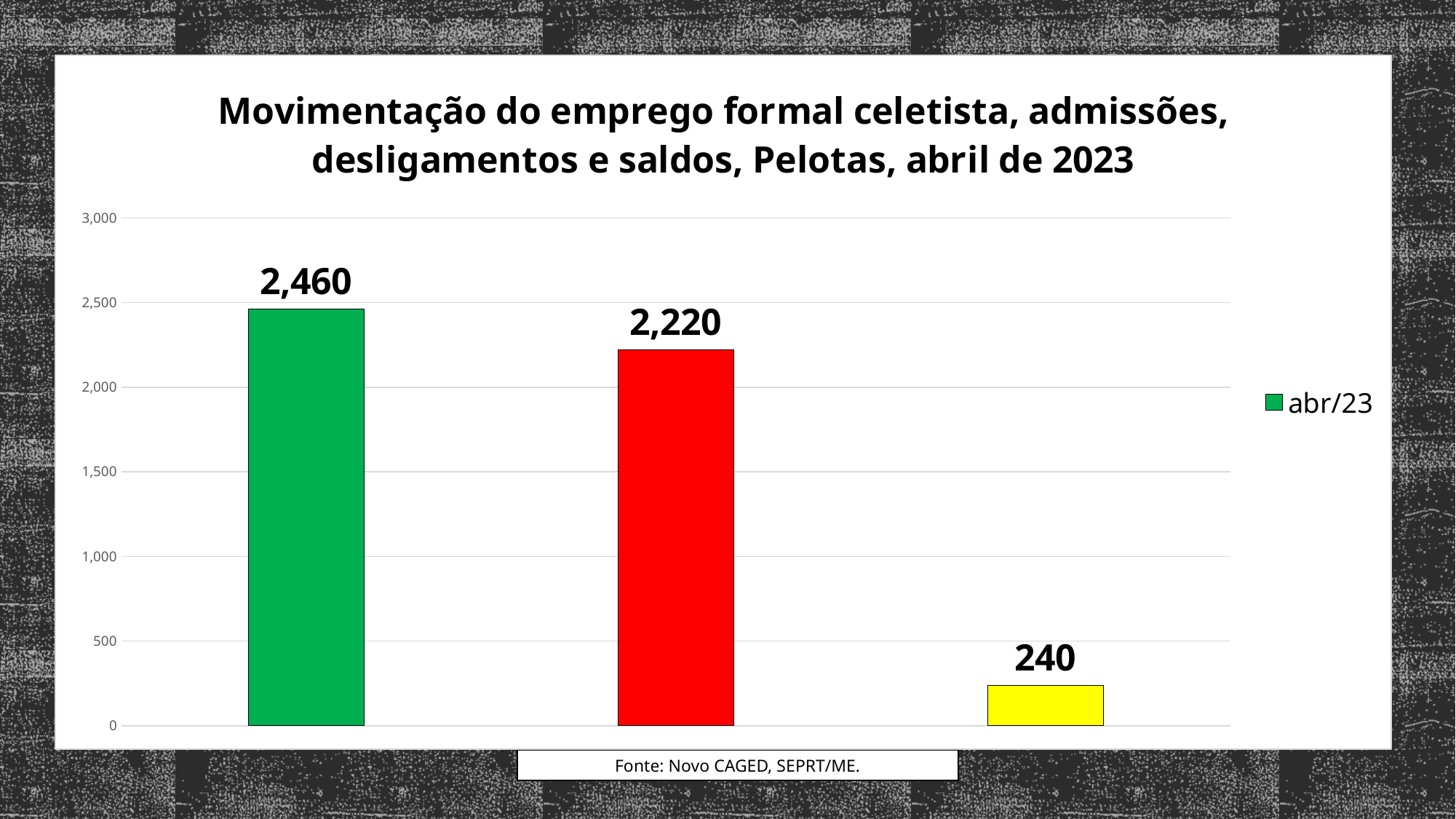
Which is larger, the value of the green bar or the value of the red bar? green bar What kind of chart is shown on the slide? bar chart Which bar has the highest value: the green, red or yellow one? green Which bar has the lowest value: the green, red or yellow one? yellow What is the value shown on the yellow bar? 240 How many bars are plotted in the chart? 3 What is the difference between the green bar's value and the red bar's value? 240 What is the value shown on the red bar? 2,220 What entry does the chart legend show? abr/23 What is the difference between the red bar's value and the yellow bar's value? 1,980 What is the value shown on the green bar? 2,460 Is the value of the yellow bar greater or less than 500? less